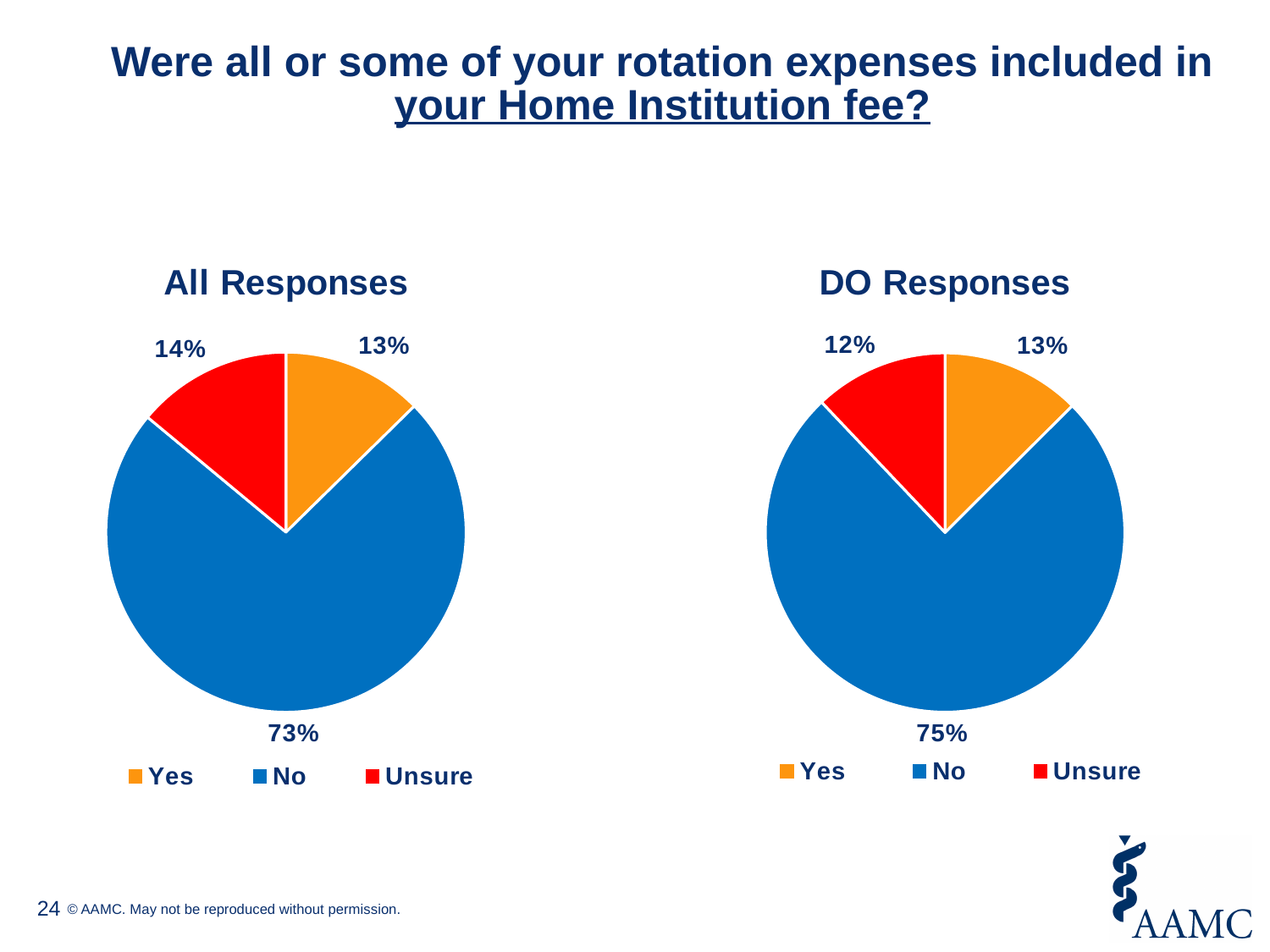
In the DO Responses chart, which response has the smallest share? Unsure In the DO Responses chart, what percentage of respondents answered Unsure? 12% In the All Responses chart, what colour represents the Unsure slice? Red How many slices does the DO Responses pie chart have? 3 Is the No share larger in the All Responses chart or the DO Responses chart? DO Responses What type of chart is the All Responses chart? Pie chart In the All Responses chart, what percentage of respondents answered No? 73% In the All Responses chart, what percentage of respondents answered Yes? 13% In the DO Responses chart, what percentage of respondents answered No? 75% How many entries does the legend of the DO Responses chart list? 3 In the All Responses chart, which response has the largest share? No In the All Responses chart, what is the difference between the No share and the Unsure share? 59%